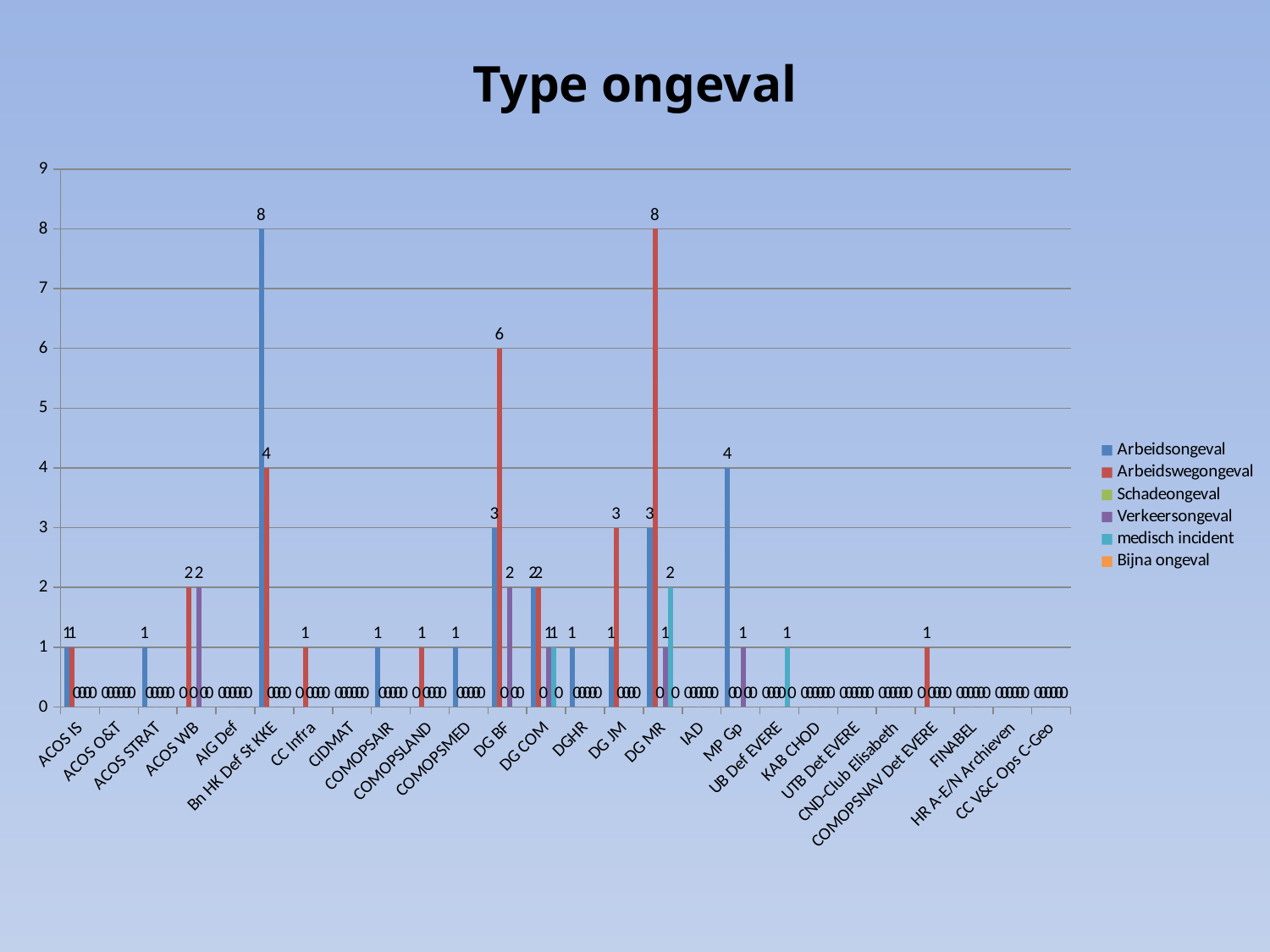
Which category has the highest Arbeidsongeval value? Bn HK Def St KKE What is the Arbeidsongeval value for MP Gp? 4 What is the difference between the Arbeidsongeval and Arbeidswegongeval values for Bn HK Def St KKE? 4 What is the Arbeidswegongeval value for DG MR? 8 How many series does the legend list? 6 What is the Arbeidswegongeval value for DG BF? 6 What is the medisch incident value for DG MR? 2 For DG BF, which is larger: Arbeidsongeval or Arbeidswegongeval? Arbeidswegongeval What is the Arbeidsongeval value for Bn HK Def St KKE? 8 What is the title of the chart? Type ongeval How many categories are shown on the x axis? 26 What kind of chart is shown on the slide? bar chart